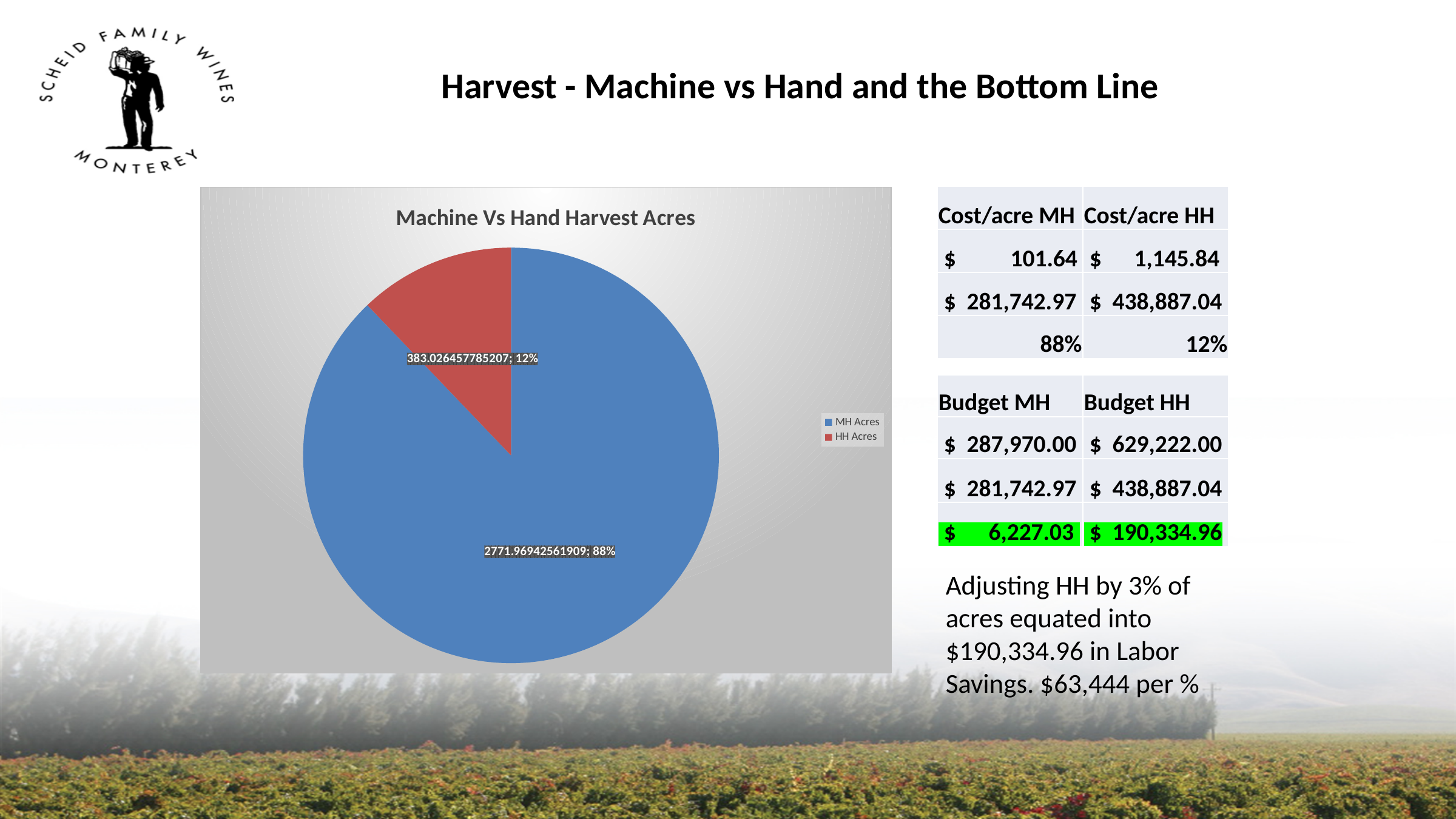
How many slices does the pie chart have? 2 Which slice of the pie is the largest? MH Acres What is the value shown for MH Acres in the pie chart? 2771.96942561909 Which slice of the pie is the smallest? HH Acres What share of the pie does HH Acres represent? 12% Which is larger, MH Acres or HH Acres? MH Acres What kind of chart is shown on the slide? pie chart What is the title of the chart? Machine Vs Hand Harvest Acres What is the value shown for HH Acres in the pie chart? 383.026457785207 What colour is the HH Acres slice in the pie chart? red What share of the pie does MH Acres represent? 88% How many entries does the chart legend list? 2